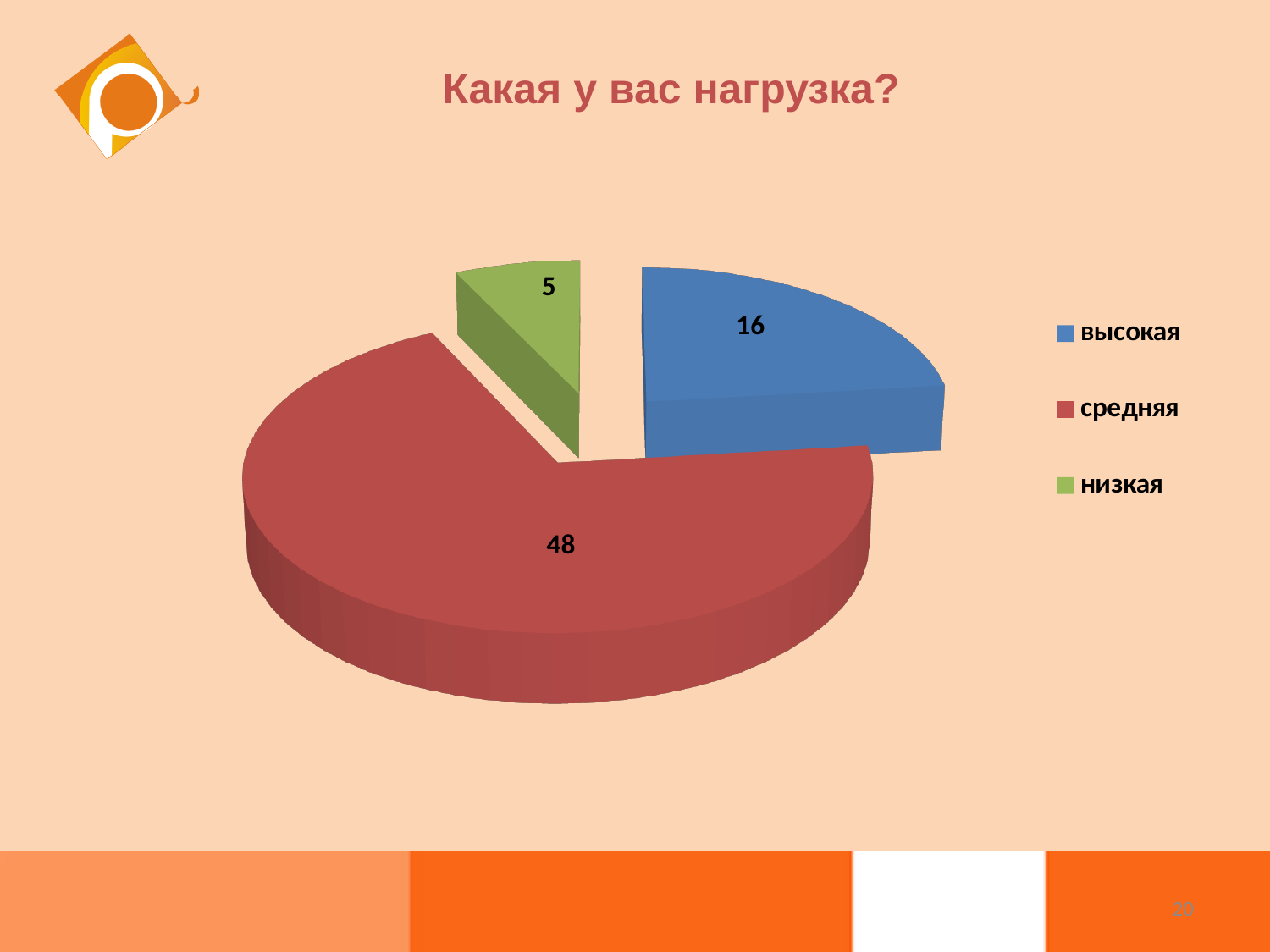
What is the sum of all the values shown in the pie chart? 69 What kind of chart is shown on the slide? pie chart Which category has the smallest slice of the pie? низкая What is the difference between the values for "средняя" and "высокая"? 32 How many slices does the pie chart have? 3 Which is larger, the value for "высокая" or the value for "низкая"? высокая Which category has the largest slice of the pie? средняя What is the difference between the values for "высокая" and "низкая"? 11 What is the value for the "высокая" slice? 16 What is the title of the chart on the slide? Какая у вас нагрузка? What is the value for the "низкая" slice? 5 What is the value for the "средняя" slice? 48